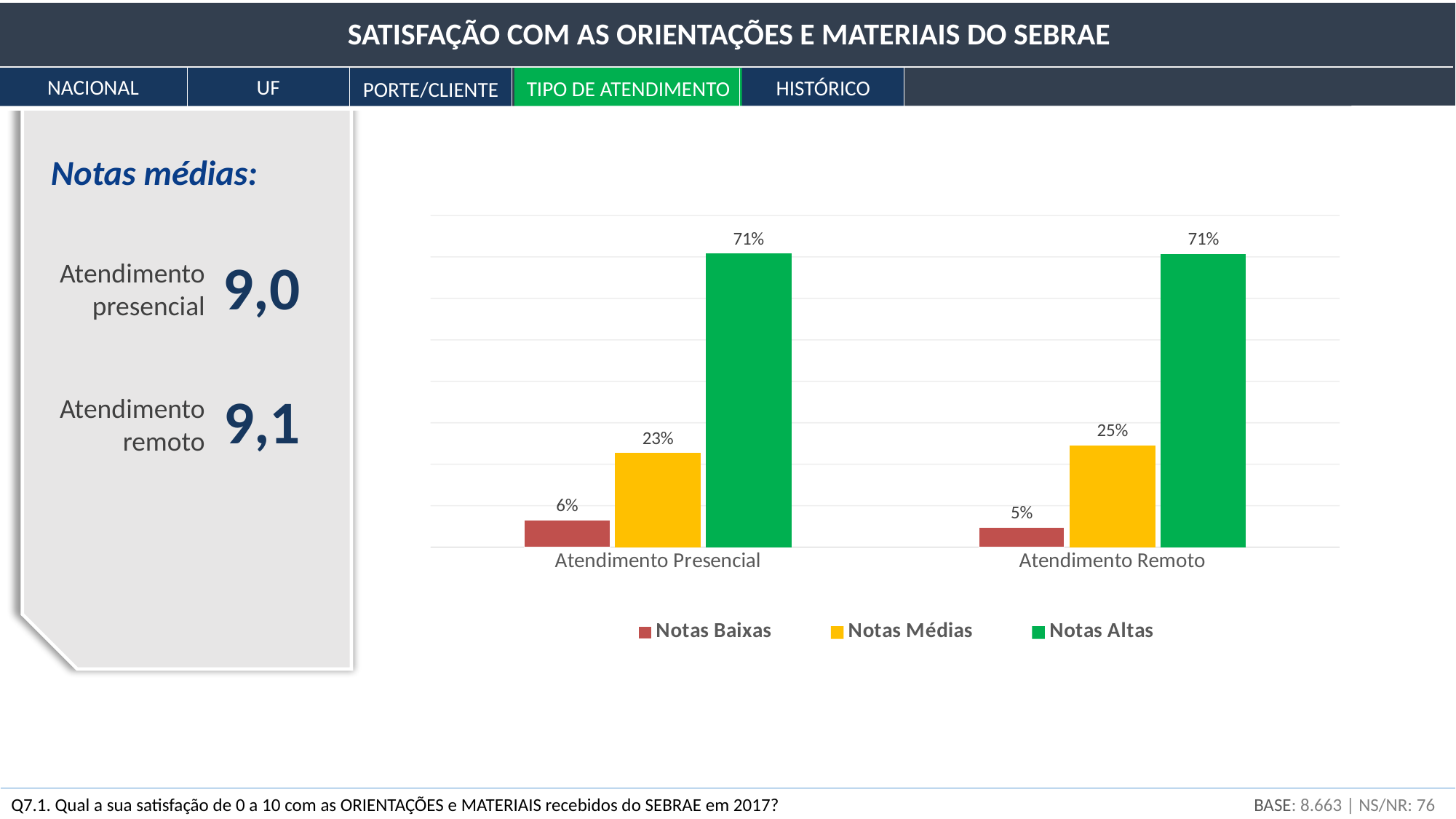
What is the value of Notas Altas for Atendimento Presencial? 71% What is the difference between Notas Médias for Atendimento Remoto and Notas Médias for Atendimento Presencial? 2% Which series has the highest value for Atendimento Remoto? Notas Altas What is the value of Notas Médias for Atendimento Remoto? 25% What is the value of Notas Baixas for Atendimento Remoto? 5% What is the value of Notas Baixas for Atendimento Presencial? 6% How many series does the chart legend list? 3 How many categories are shown on the x axis of the chart? 2 Which is larger: Notas Baixas for Atendimento Presencial or Notas Baixas for Atendimento Remoto? Atendimento Presencial What kind of chart is shown on the slide? Bar chart What colour represents the Notas Altas series in the chart? Green Which series has the lowest value for Atendimento Presencial? Notas Baixas